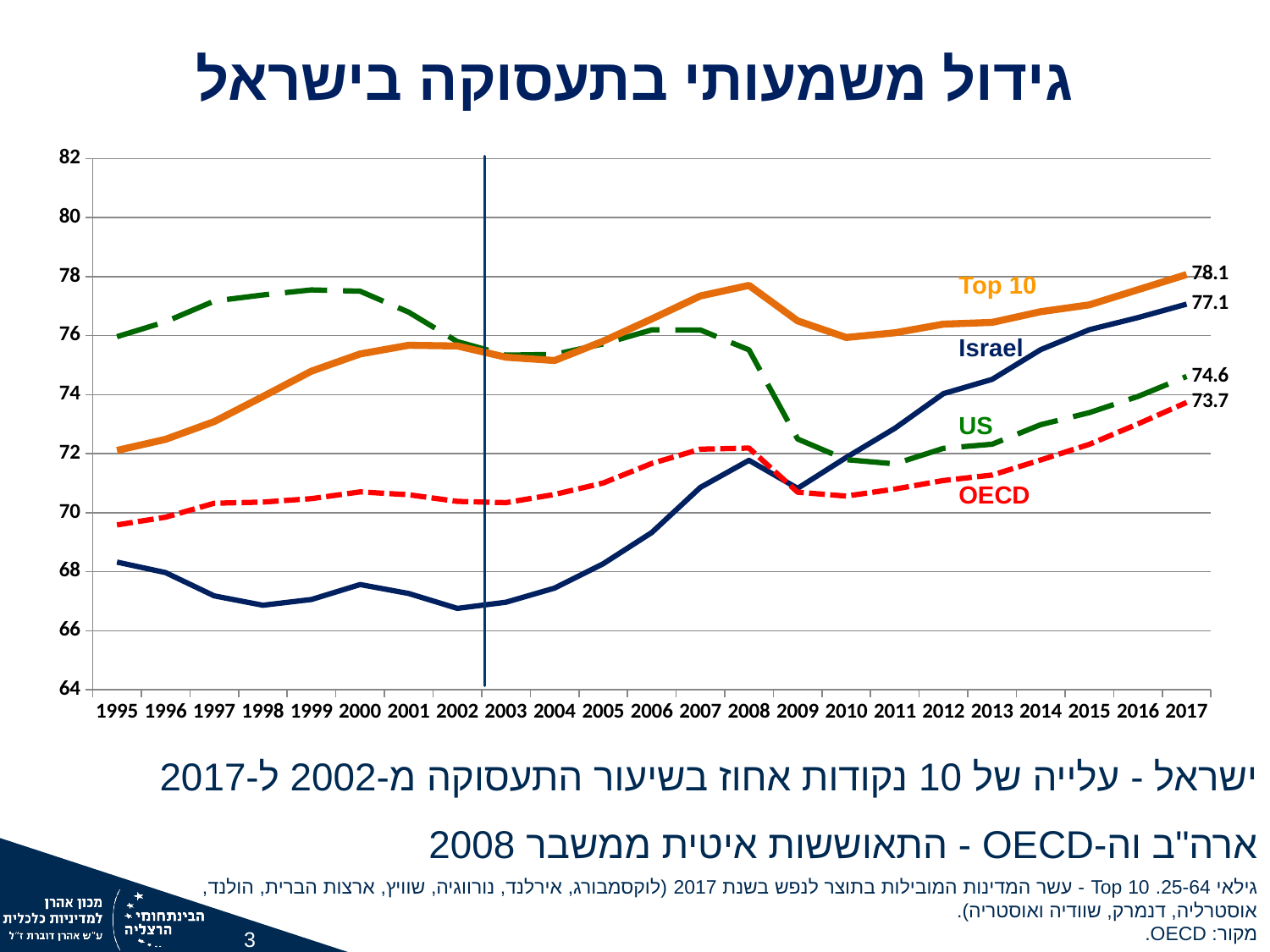
What is the difference between the Israel and OECD values in 2017? 3.4 In 2017, which is larger: the value for Israel or the value for US? Israel How many series are plotted on the chart? 4 What is the value for Israel in 2017? 77.1 Is the value for Israel in 1995 greater or less than 70? less Does the Israel line rise or fall from 2002 to 2017? rise Which series has the lowest value in 2017? OECD What is the value for US in 2017? 74.6 Which series has the highest value in 2017? Top 10 What kind of chart is shown on the slide? line chart What is the value for Top 10 in 2017? 78.1 What is the value for OECD in 2017? 73.7